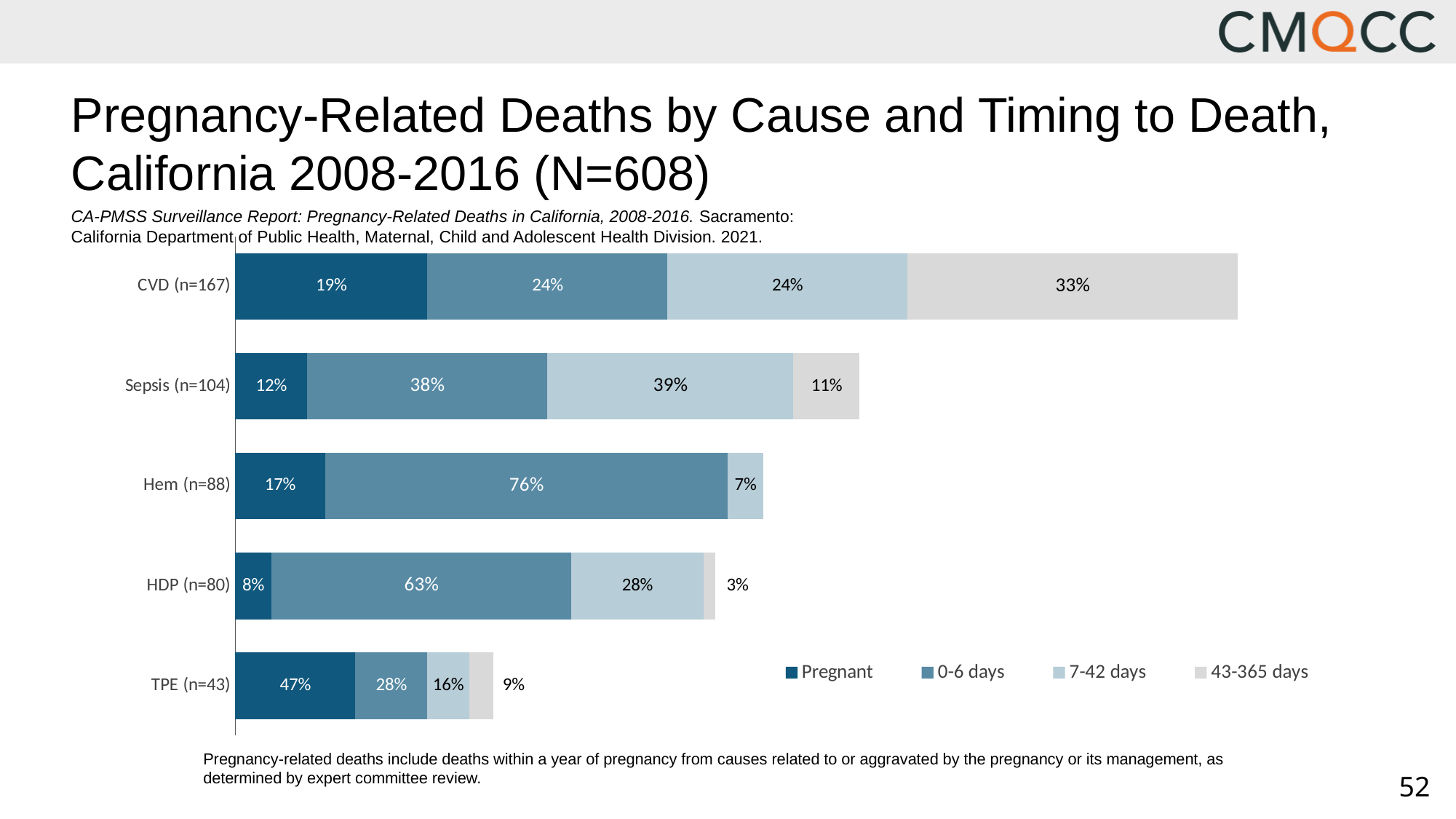
Which legend entry is shown in the lightest grey colour? 43-365 days How many timing categories does the legend list? 4 How many causes of death are shown on the chart? 5 Which cause has the highest percentage of deaths in the 0-6 days period? Hem (n=88) What percentage of Sepsis (n=104) deaths occurred in the 7-42 days period? 39% Which cause has the lowest percentage of deaths occurring while pregnant? HDP (n=80) What type of chart is shown on the slide? Stacked bar chart What percentage of Hem (n=88) deaths occurred 0-6 days after pregnancy? 76% What percentage of CVD (n=167) pregnancy-related deaths occurred 43-365 days after pregnancy? 33% Which is larger: the 7-42 days percentage for CVD (n=167) or for HDP (n=80)? HDP (n=80) What percentage of TPE (n=43) deaths occurred while pregnant? 47% What is the difference between the 0-6 days percentage for HDP (n=80) and for Sepsis (n=104)? 25%